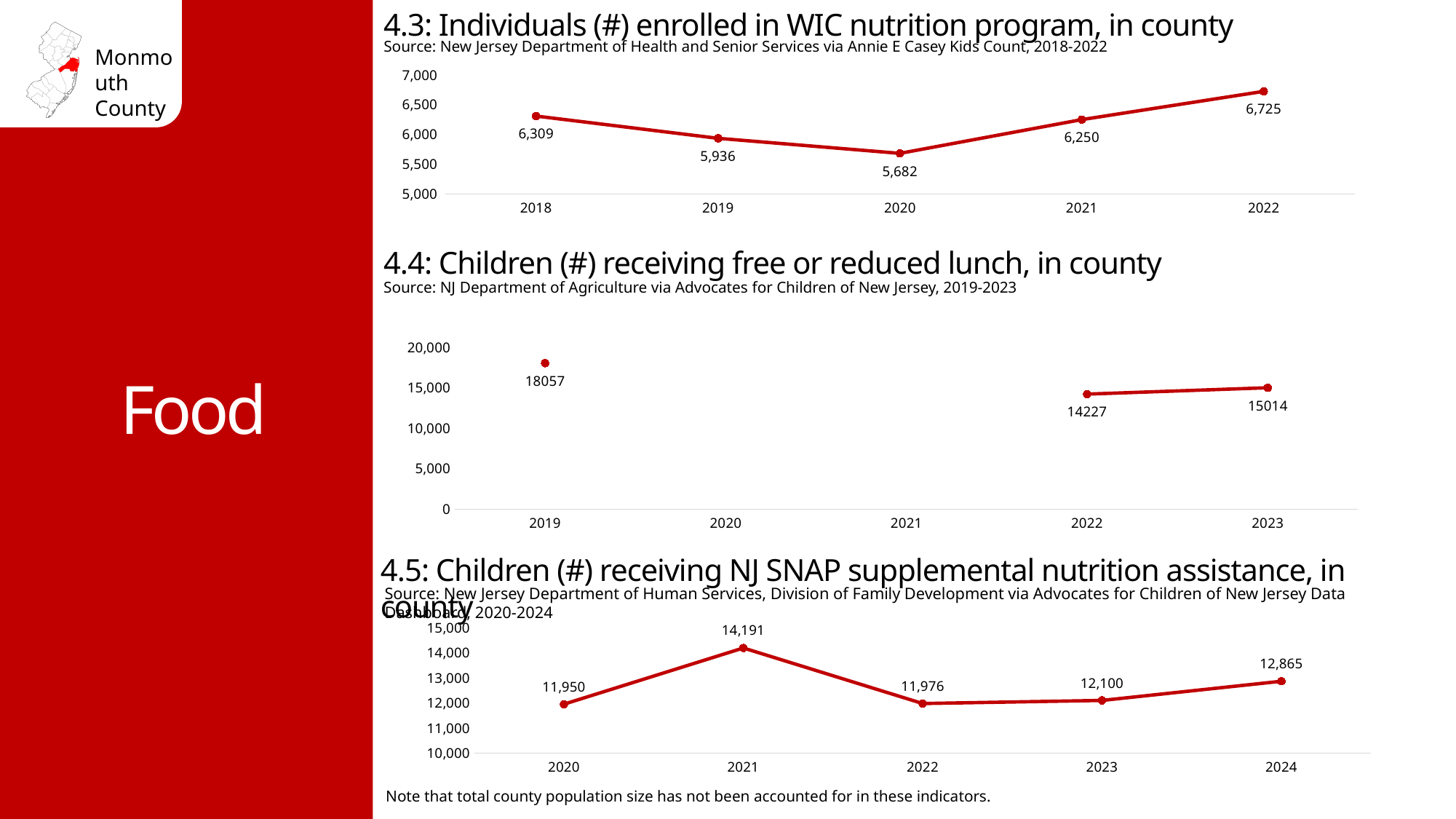
In the chart '4.5: Children (#) receiving NJ SNAP supplemental nutrition assistance, in county', what is the difference between the 2024 and 2023 values? 765 In the chart '4.4: Children (#) receiving free or reduced lunch, in county', which is larger, the value for 2022 or the value for 2023? 2023 In the chart '4.4: Children (#) receiving free or reduced lunch, in county', what is the value for 2019? 18057 In the chart '4.3: Individuals (#) enrolled in WIC nutrition program, in county', what is the difference between the 2022 and 2018 values? 416 In the chart '4.3: Individuals (#) enrolled in WIC nutrition program, in county', which year has the highest value? 2022 In the chart '4.5: Children (#) receiving NJ SNAP supplemental nutrition assistance, in county', which year has the lowest value? 2020 In the chart '4.4: Children (#) receiving free or reduced lunch, in county', what is the difference between the 2023 and 2022 values? 787 In the chart '4.3: Individuals (#) enrolled in WIC nutrition program, in county', how many data points are plotted? 5 What kind of chart is '4.5: Children (#) receiving NJ SNAP supplemental nutrition assistance, in county'? Line chart In the chart '4.3: Individuals (#) enrolled in WIC nutrition program, in county', which year has the lowest value? 2020 In the chart '4.3: Individuals (#) enrolled in WIC nutrition program, in county', what is the value for 2020? 5,682 In the chart '4.5: Children (#) receiving NJ SNAP supplemental nutrition assistance, in county', what is the value for 2021? 14,191